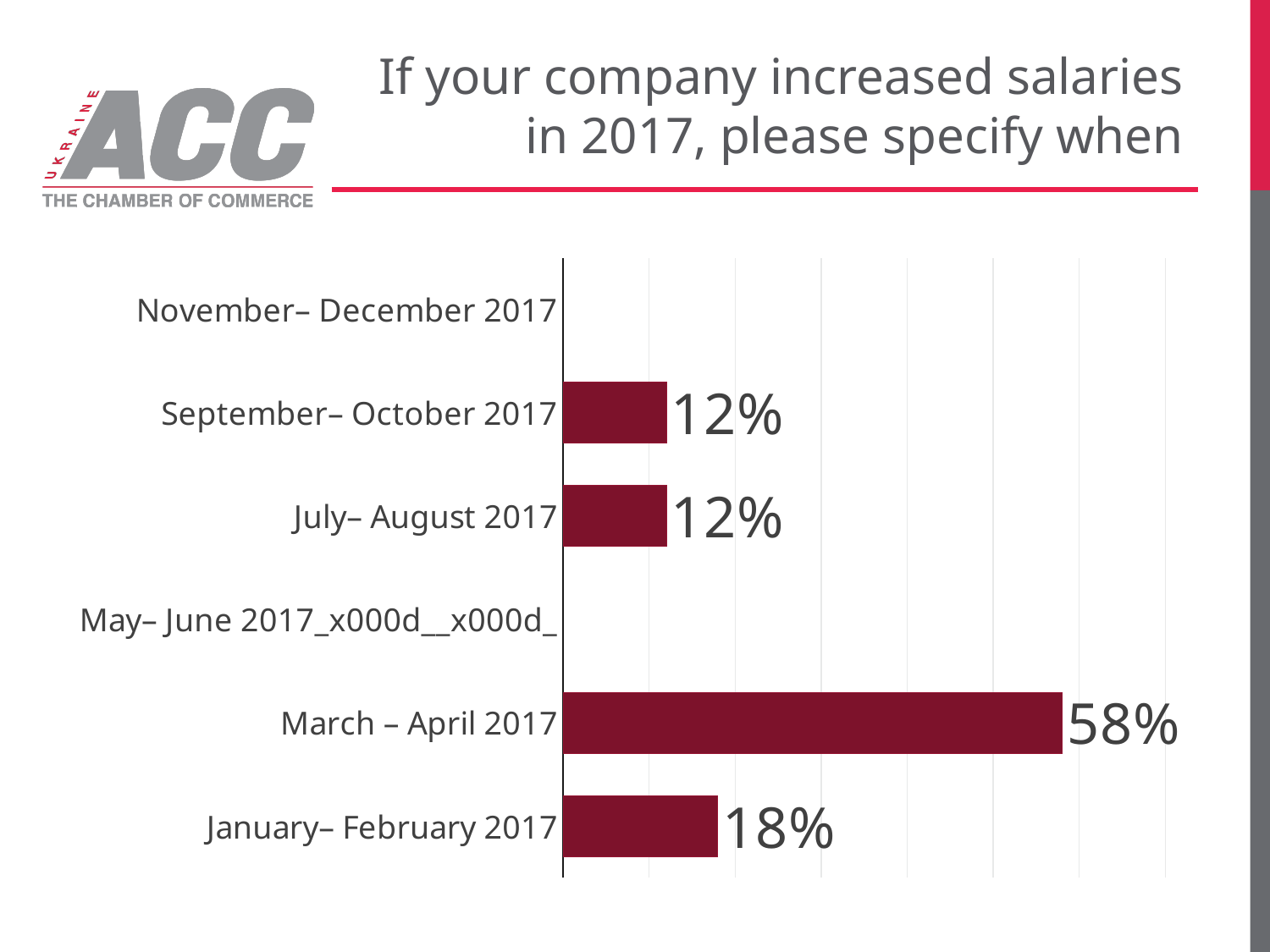
What is the value shown for July– August 2017? 12% What is the value shown for January– February 2017? 18% What is the value shown for September– October 2017? 12% What is the title of the slide? If your company increased salaries in 2017, please specify when Which is larger, the value for January– February 2017 or the value for September– October 2017? January– February 2017 What colour are the bars in the chart? Dark red What percentage of companies increased salaries in March – April 2017? 58% What is the difference between the values for January– February 2017 and July– August 2017? 6% What kind of chart is shown on the slide? Bar chart How many periods (categories) are listed on the chart's vertical axis? 6 Which period has the highest value in the chart? March – April 2017 What is the difference between the values for March – April 2017 and January– February 2017? 40%